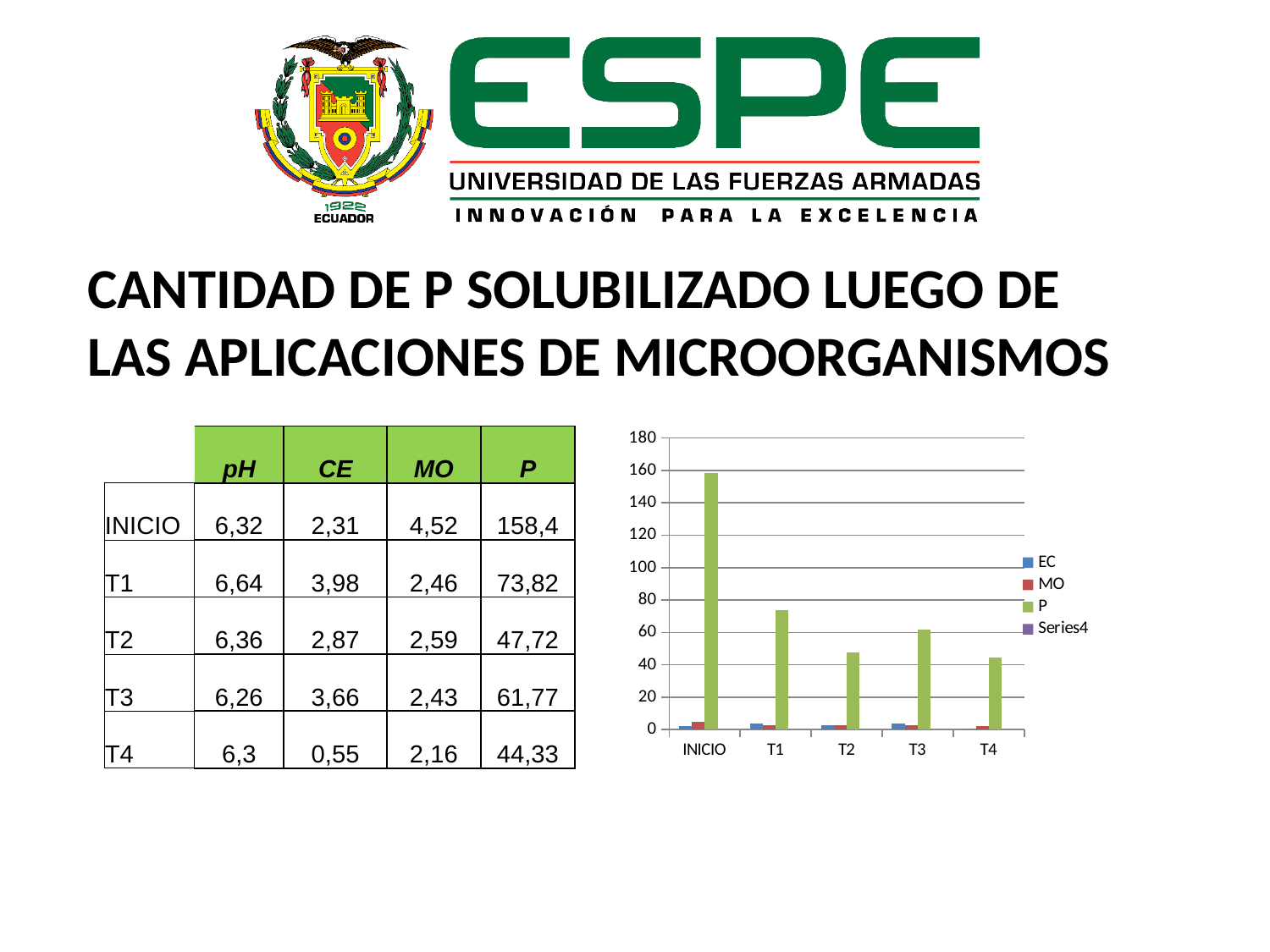
How many categories are shown on the x axis of the chart? 5 Is the value of the P series for T3 greater or less than 80? less What are the entries listed in the chart legend? EC, MO, P, Series4 What kind of chart is shown on the slide? bar chart Which category has the highest value for the P series? INICIO Is the value of the P series for T1 greater or less than 80? less Is the value of the P series for INICIO greater or less than 140? greater How many series does the chart legend list? 4 Which is larger for the P series, the value for T1 or the value for T3? T1 Does the P series rise or fall from INICIO to T2? fall